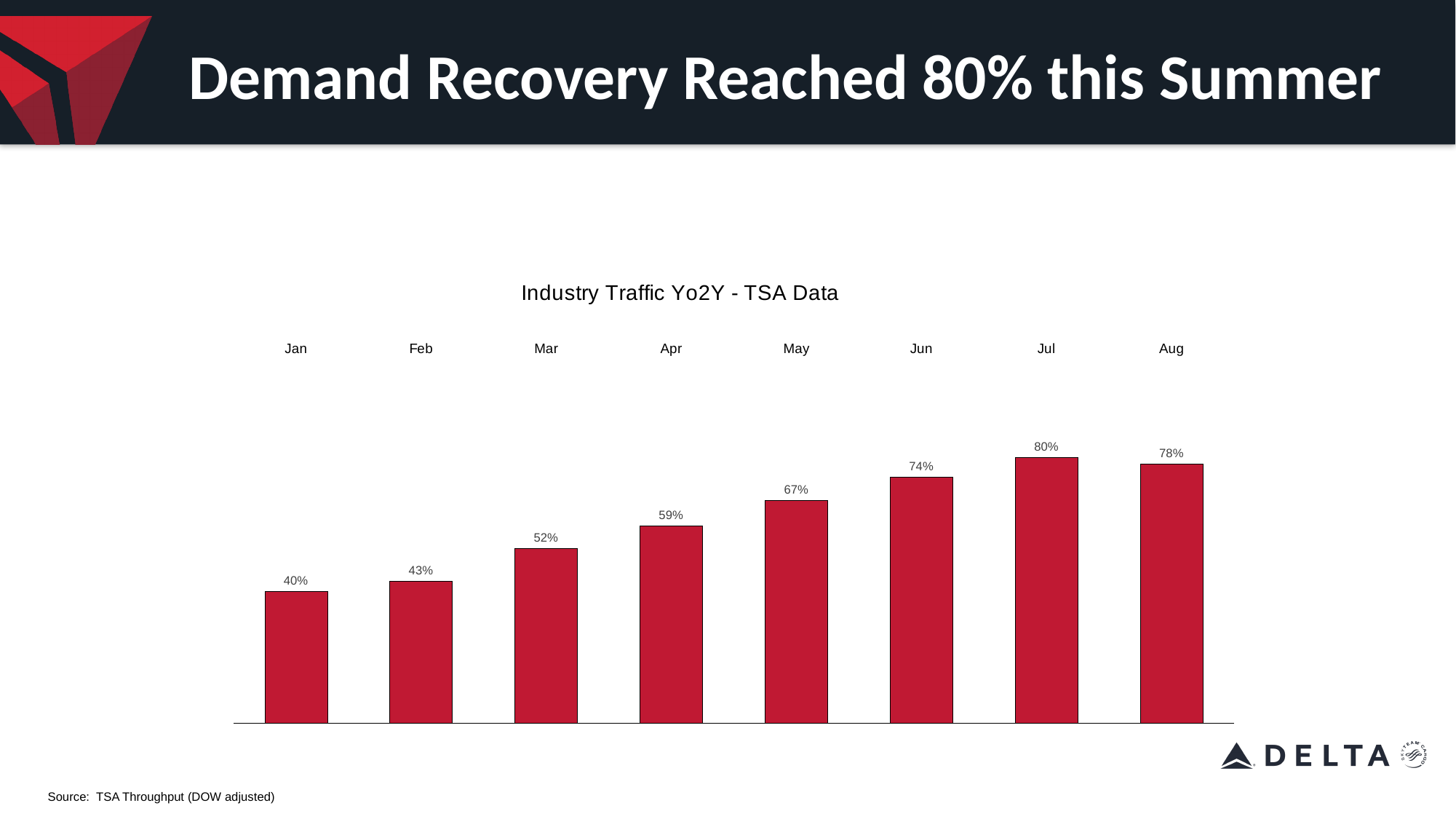
What kind of chart is shown on the slide? Bar chart What is the difference between the values for Apr and Mar? 7% Which is larger, the value for Jun or the value for Aug? Aug What is the value for Aug? 78% Do the values generally rise or fall from Jan to Jul? Rise What is the difference between the values for Jul and Jan? 40% Which month has the highest value? Jul What is the value for Jan? 40% How many months are shown on the chart? 8 What is the value for May? 67% Which month has the lowest value? Jan What is the title of the chart? Industry Traffic Yo2Y - TSA Data